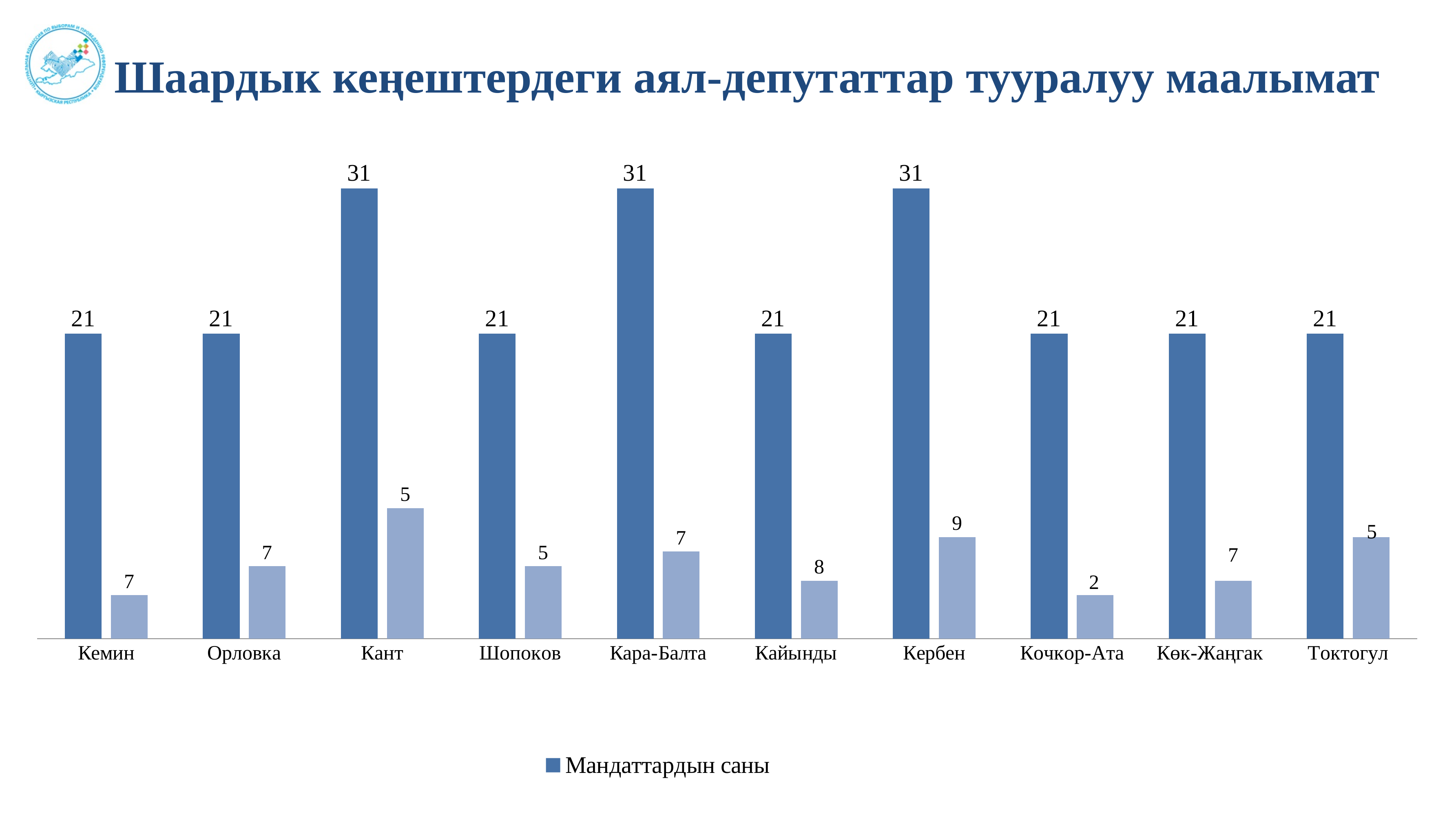
What is the value of Мандаттардын саны for Кант? 31 What is the value of the lighter blue bar for Кербен? 9 What is the difference between Мандаттардын саны and the lighter blue bar for Кара-Балта? 24 How many categories (cities) are shown on the x axis of the chart? 10 What is the legend entry shown below the chart? Мандаттардын саны How many series does the chart legend list? 1 What is the value of Мандаттардын саны for Кочкор-Ата? 21 What type of chart is shown on the slide? bar chart What is the value of the lighter blue bar for Кочкор-Ата? 2